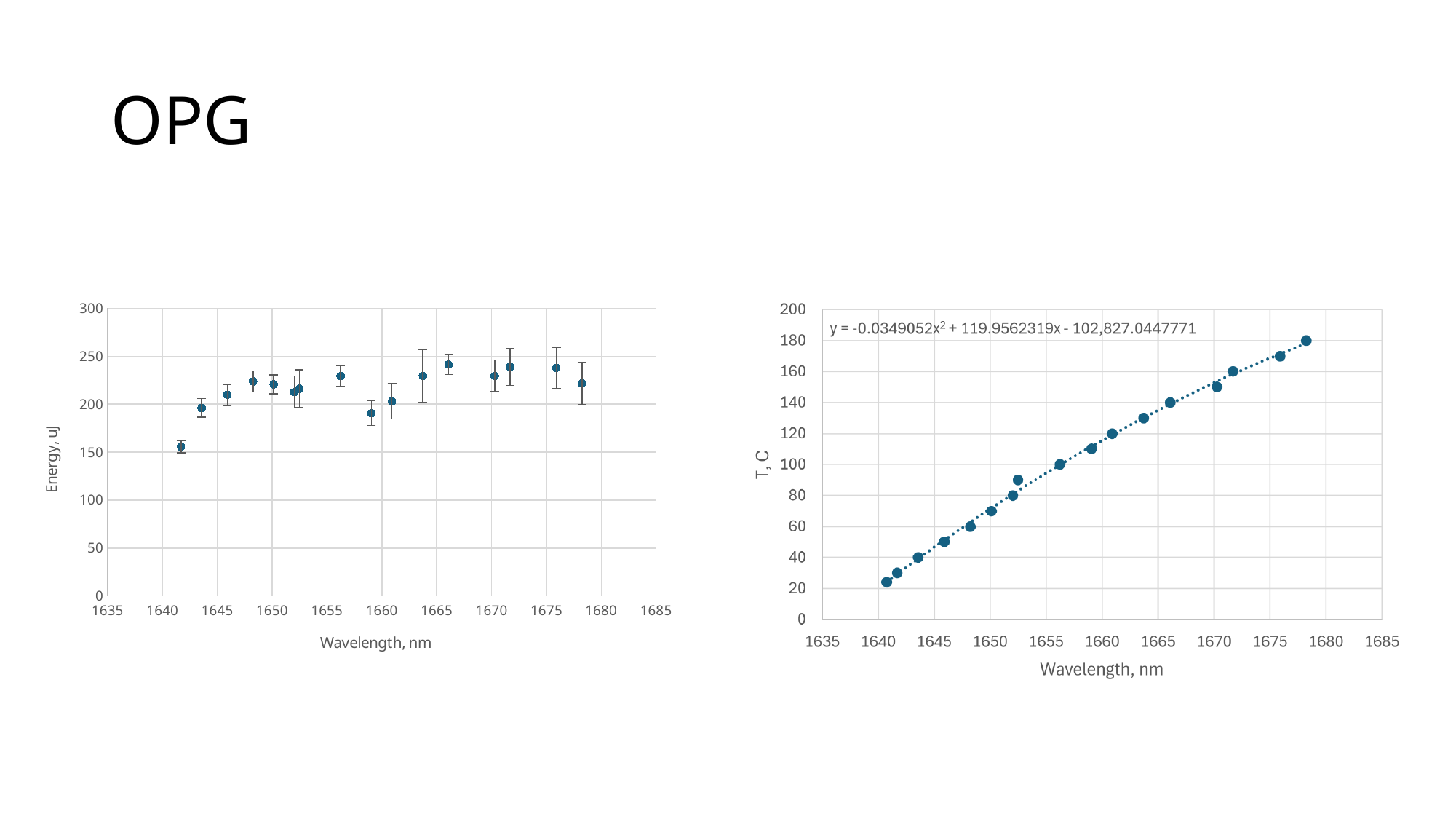
In the left chart, which point has the lowest energy: the one at about 1641 nm or the one at about 1666 nm? the one at about 1641 nm In the right chart, is the T value at about 1670 nm greater or less than 140? greater In the right chart, do the T values rise or fall as wavelength increases? rise What type of chart is the right chart (T vs Wavelength)? scatter chart In the left chart, what is the y-axis title? Energy, uJ In the left chart, is the energy value at about 1666 nm greater or less than 200? greater What type of chart is the left chart (Energy vs Wavelength)? scatter chart In the right chart, is the T value at about 1645 nm greater or less than 60? less In the right chart, what is the y-axis title? T, C In the right chart, what is the T value of the highest point? 180